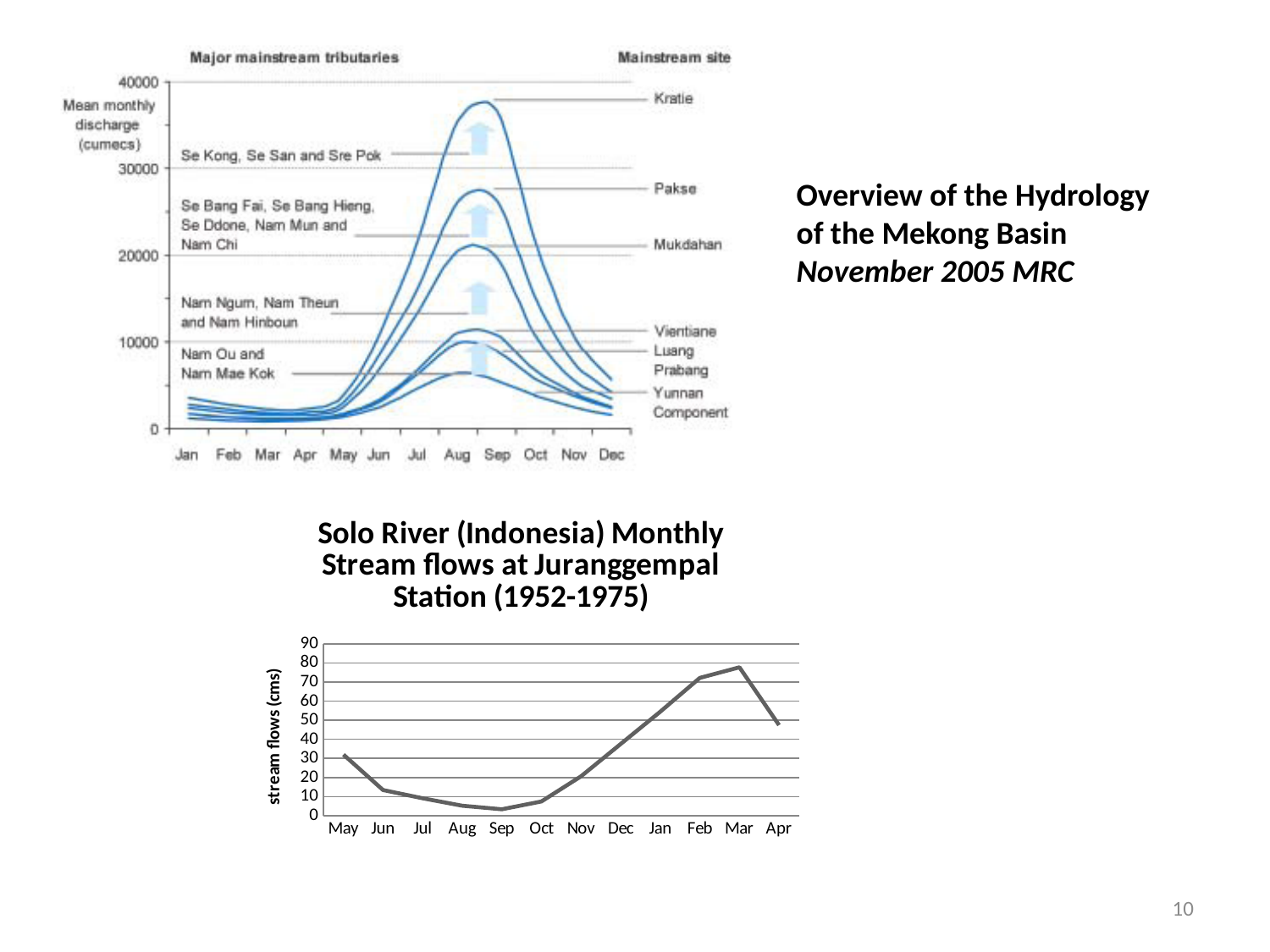
In the Solo River (Indonesia) Monthly Stream flows chart, do the values rise or fall from May to Sep? fall In the Solo River (Indonesia) Monthly Stream flows chart, which month has the lowest stream flow? Sep In the Solo River (Indonesia) Monthly Stream flows chart, which is larger, the value for Feb or the value for Jun? Feb In the Mekong mean monthly discharge chart at the top of the slide, which mainstream site has the highest peak discharge? Kratie In the Mekong mean monthly discharge chart at the top of the slide, is the peak discharge at Kratie greater or less than 30000? greater In the Solo River (Indonesia) Monthly Stream flows chart, how many months are plotted on the x axis? 12 In the Solo River (Indonesia) Monthly Stream flows chart, is the value for Mar greater or less than 70? greater In the Solo River (Indonesia) Monthly Stream flows chart, is the value for Sep greater or less than 10? less In the Solo River (Indonesia) Monthly Stream flows chart, which month has the highest stream flow? Mar What is the y-axis label of the Solo River (Indonesia) Monthly Stream flows chart? stream flows (cms) What kind of chart is the Solo River (Indonesia) Monthly Stream flows chart? line chart